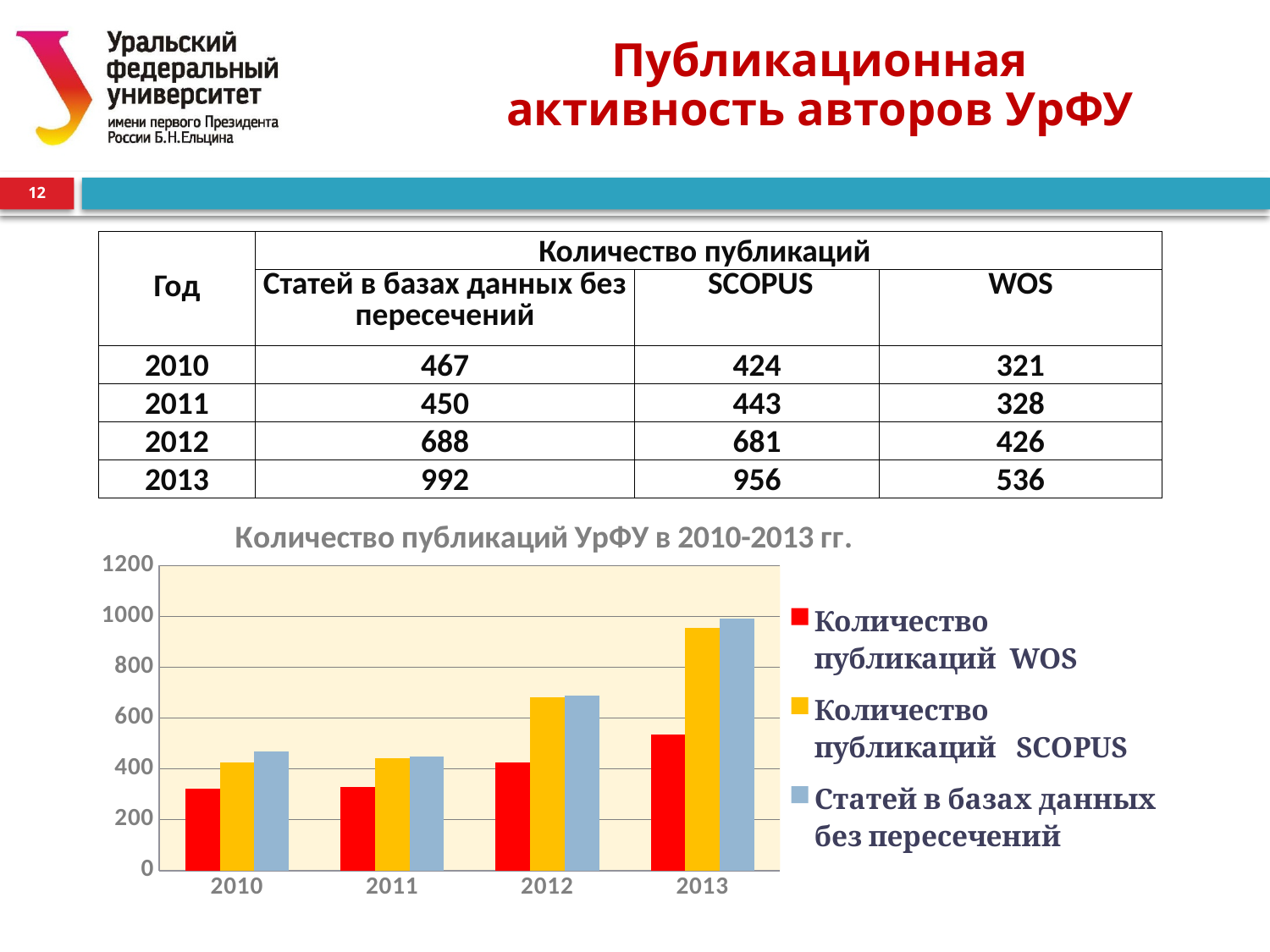
Which is larger in 2012: the WOS value or the SCOPUS value? SCOPUS How many years are shown on the x axis of the chart? 4 What kind of chart is shown on the slide? bar chart In which year is the value for 'Статей в базах данных без пересечений' the highest? 2013 What is the number of SCOPUS publications in 2012? 681 In which year is the value for 'Количество публикаций WOS' the lowest? 2010 What is the number of WOS publications in 2013? 536 Is the value for 'Количество публикаций SCOPUS' in 2013 greater or less than 800? greater Which colour represents the series 'Количество публикаций WOS' in the chart? red How many series does the chart legend list? 3 What is the difference between the SCOPUS values for 2013 and 2012? 275 What is the title of the chart? Количество публикаций УрФУ в 2010-2013 гг.